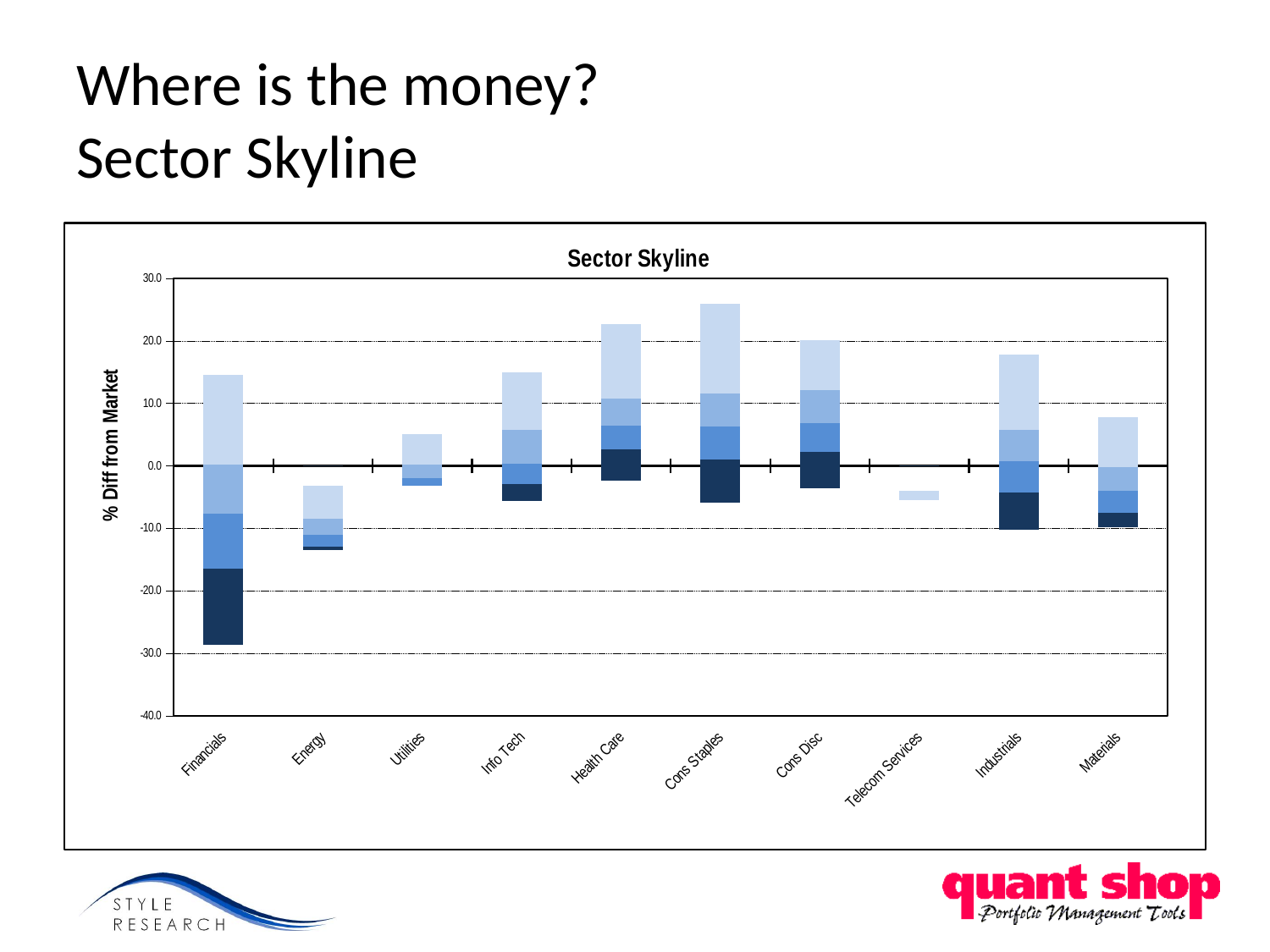
Is the top of the Cons Staples bar greater or less than 20.0? greater What is the title of the chart? Sector Skyline Is the lowest point of the Financials bar greater or less than -20.0? less Is the lowest point of the Energy bar greater or less than -10.0? less What kind of chart is shown on the slide? bar chart What is the label on the vertical axis of the chart? % Diff from Market Which sector's bar extends to the lowest point on the chart? Financials Which sector's bar reaches the highest point on the chart? Cons Staples How many sectors are shown along the x axis of the Sector Skyline chart? 10